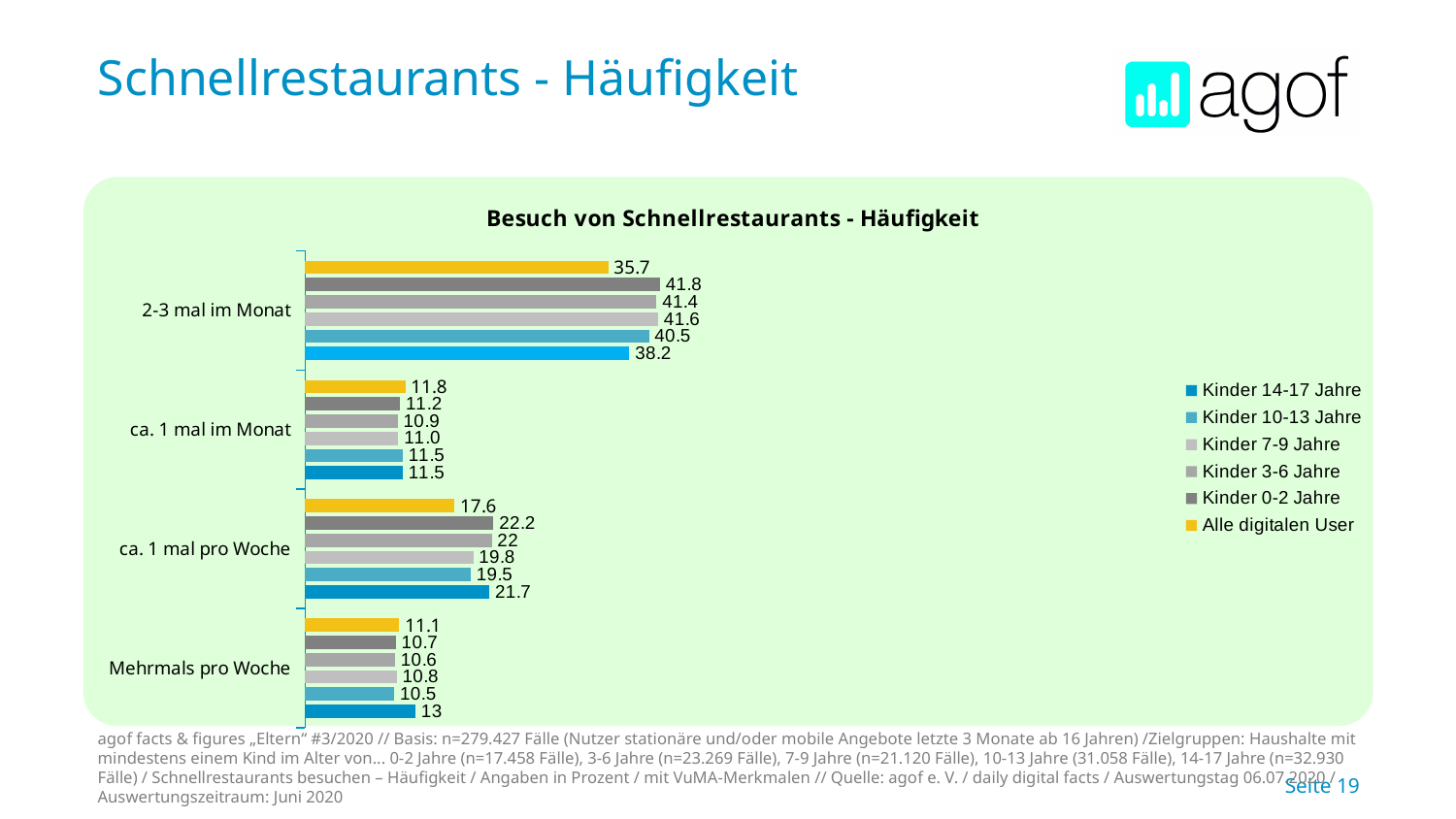
What is the difference between the values for Kinder 0-2 Jahre and Alle digitalen User in the category "2-3 mal im Monat"? 6.1 Which series has the lowest value in the category "Mehrmals pro Woche"? Kinder 10-13 Jahre In the category "ca. 1 mal pro Woche", which is larger: the value for Kinder 14-17 Jahre or the value for Kinder 7-9 Jahre? Kinder 14-17 Jahre Which series has the highest value in the category "2-3 mal im Monat"? Kinder 0-2 Jahre What is the value for Kinder 0-2 Jahre in the category "ca. 1 mal pro Woche"? 22.2 What kind of chart is shown on the slide? Bar chart How many series does the legend list? 6 How many categories are shown on the chart? 4 What is the value for Kinder 14-17 Jahre in the category "Mehrmals pro Woche"? 13 What is the value for Kinder 7-9 Jahre in the category "ca. 1 mal im Monat"? 11.0 What is the title of the chart? Besuch von Schnellrestaurants - Häufigkeit What is the value for Alle digitalen User in the category "2-3 mal im Monat"? 35.7